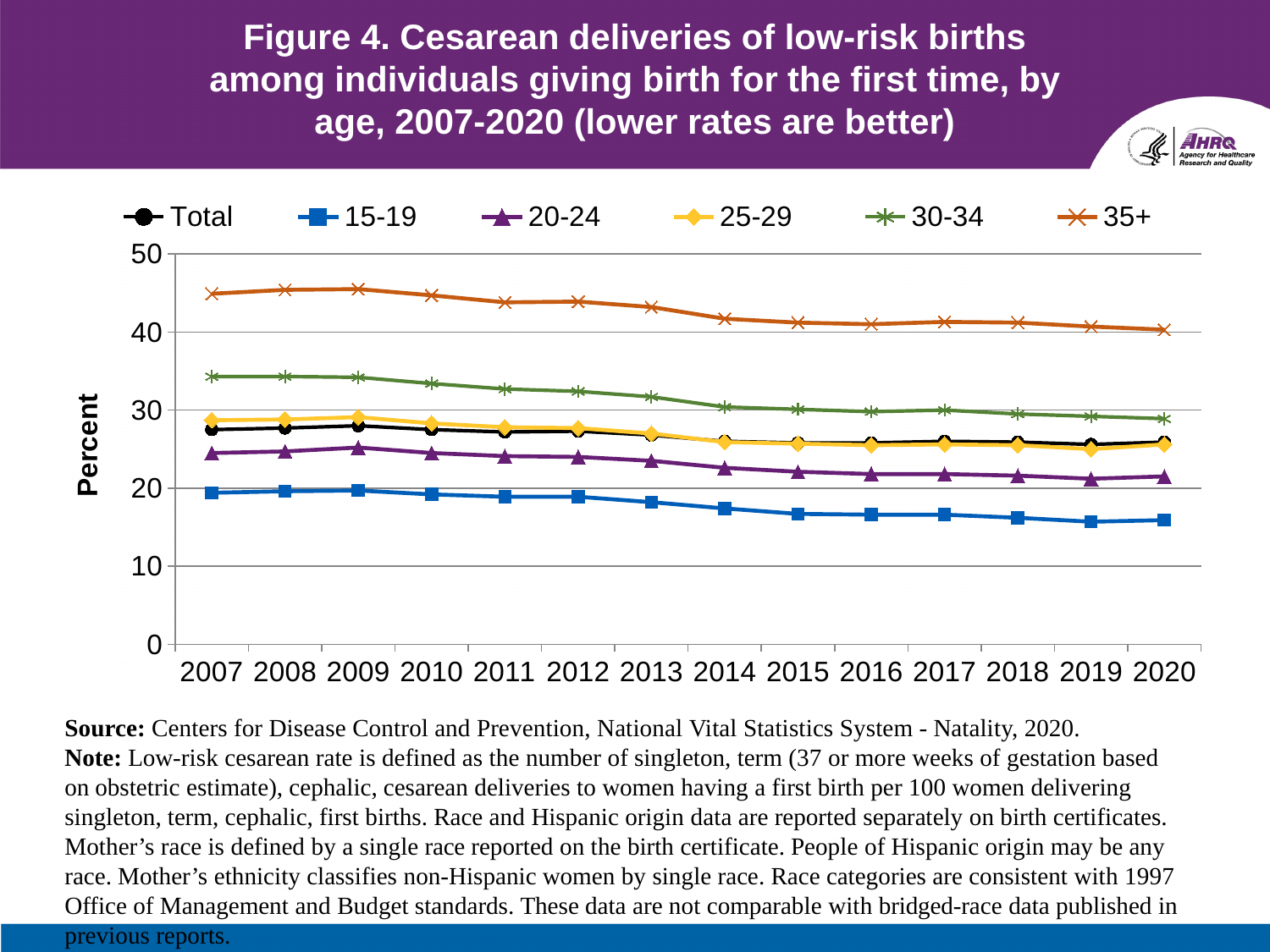
How many years are plotted along the x axis? 14 Which age group has the lowest cesarean delivery rate in 2007? 15-19 Is the value for the 35+ group in 2007 greater or less than 40? greater Is the value for the 15-19 group in 2020 greater or less than 20? less What kind of chart is shown on the slide? line chart In 2010, which is larger: the value for the 30-34 group or the 25-29 group? 30-34 Is the value for the Total series in 2020 greater or less than 30? less Which age group has the highest cesarean delivery rate in 2020? 35+ What is the label on the y axis? Percent Does the rate for the 35+ group rise or fall from 2007 to 2020? fall How many series does the legend list? 6